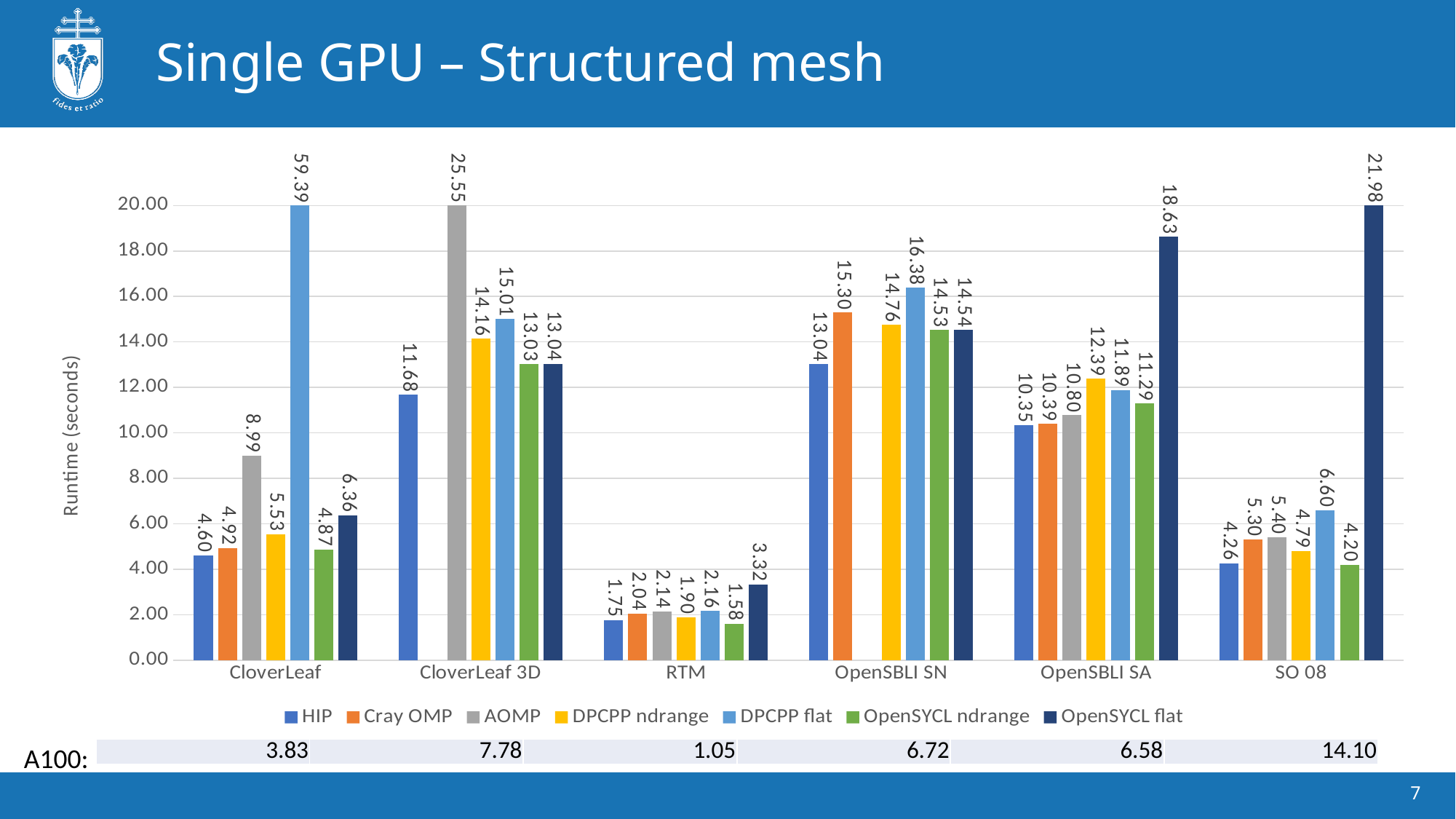
What is the runtime for AOMP on CloverLeaf 3D? 25.55 What is the label of the y axis? Runtime (seconds) What kind of chart is shown on the slide? Bar chart What is the runtime for DPCPP flat on OpenSBLI SN? 16.38 How many application categories are shown on the x axis? 6 What is the runtime for OpenSYCL flat on SO 08? 21.98 Which series has the lowest runtime for RTM? OpenSYCL ndrange Which series has the highest runtime for OpenSBLI SA? OpenSYCL flat What is the runtime for HIP on CloverLeaf? 4.60 Which is larger for SO 08, the DPCPP flat runtime or the Cray OMP runtime? DPCPP flat How many series does the legend list? 7 What is the difference between the OpenSYCL flat and HIP runtimes for RTM? 1.57